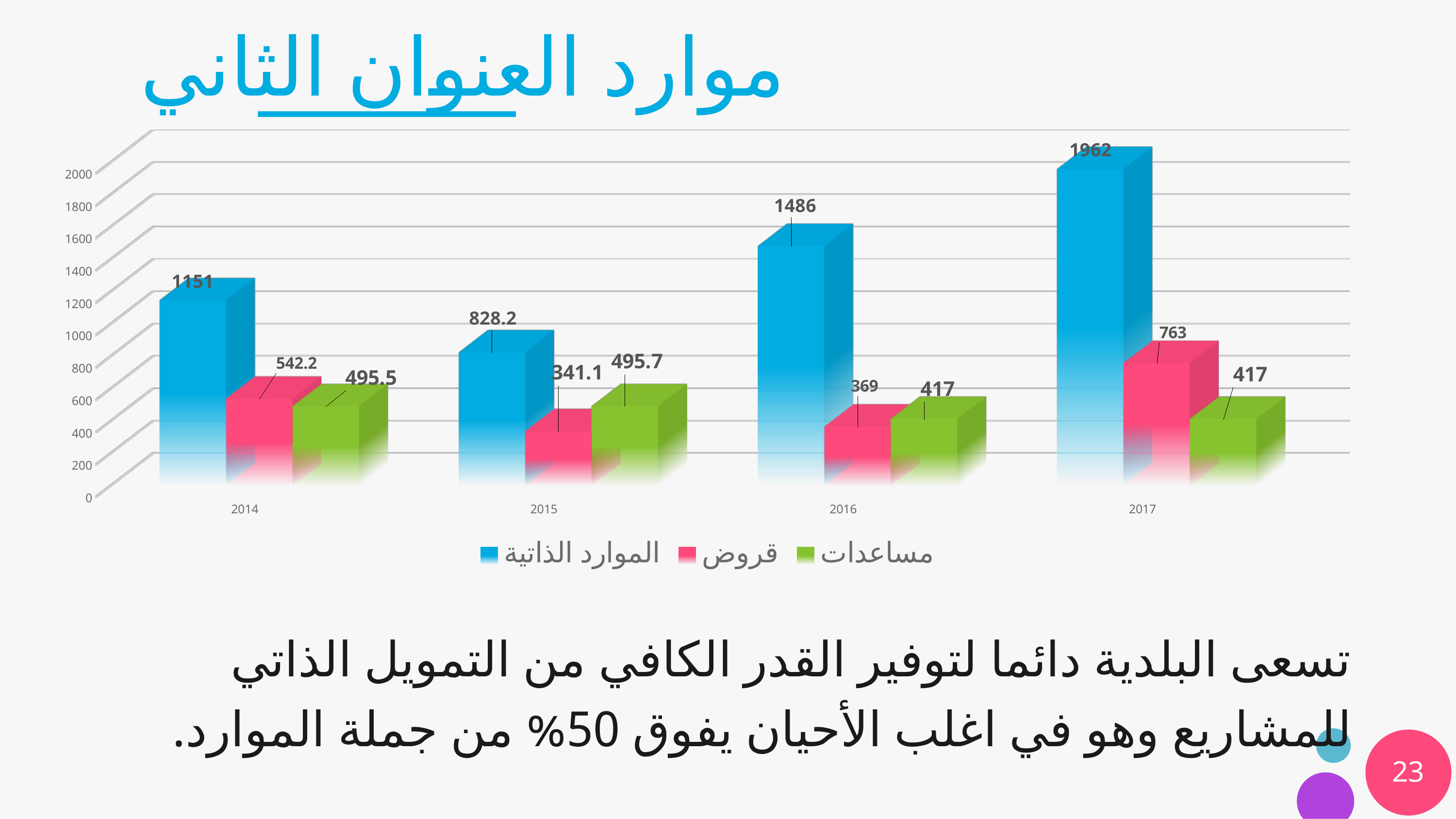
Is the value of الموارد الذاتية for 2015 greater or less than 1000? less Which is larger in 2014: قروض or مساعدات? قروض In which year is الموارد الذاتية highest? 2017 How many years are shown on the x axis? 4 How many series does the legend list? 3 What is the value of قروض for 2015? 341.1 In which year is قروض lowest? 2015 What kind of chart is shown on the slide? bar chart What is the difference between الموارد الذاتية in 2017 and in 2016? 476 Which colour represents مساعدات in the legend? green What is the value of مساعدات for 2014? 495.5 What is the value of الموارد الذاتية for 2017? 1962